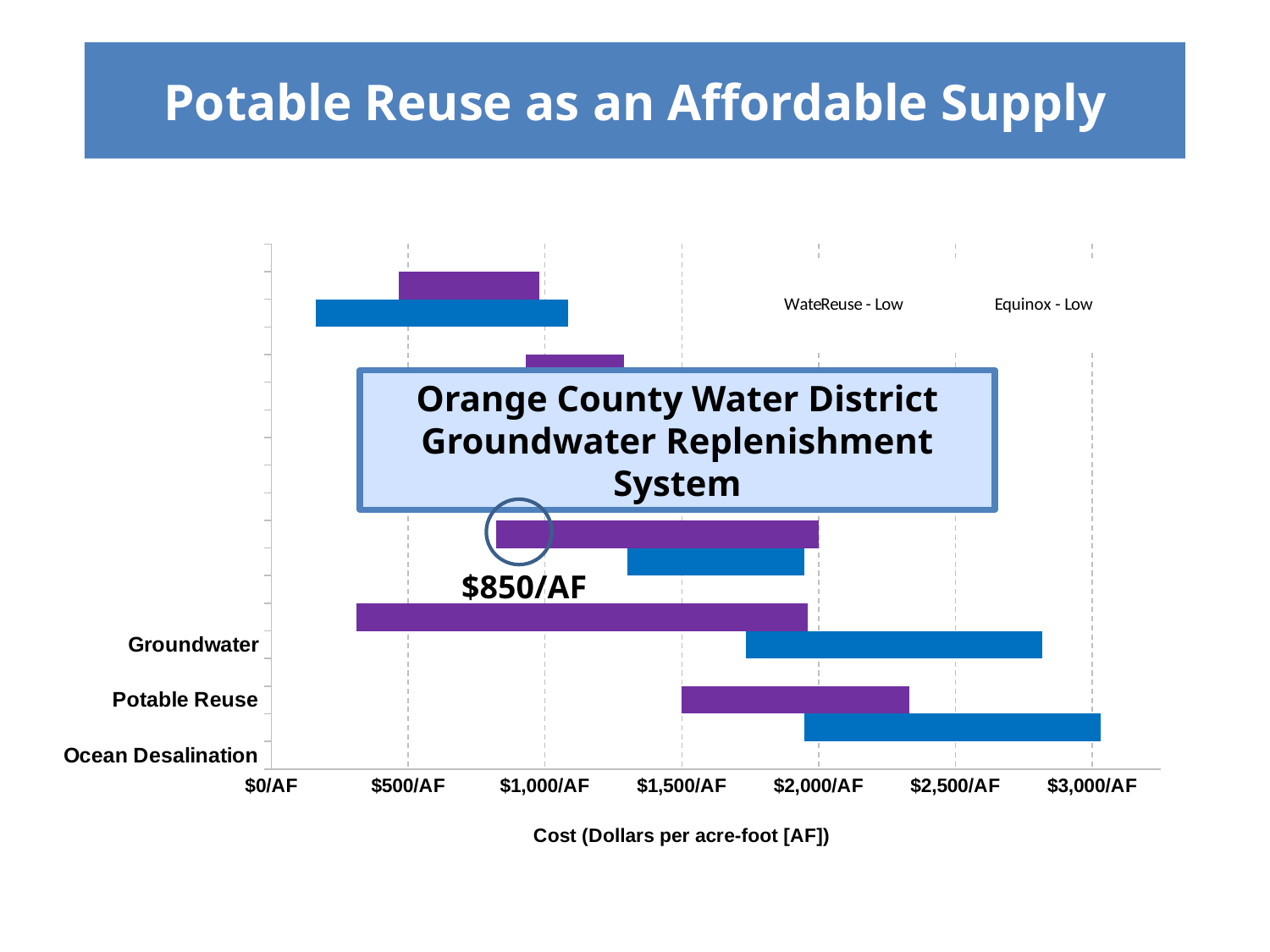
What are the two legend entries shown on the chart? WateReuse - Low and Equinox - Low Is the annotated cost for the Orange County Water District Groundwater Replenishment System greater or less than $1,000/AF? less What cost per acre-foot is annotated for the Orange County Water District Groundwater Replenishment System? $850/AF Is the annotated cost for the Orange County Water District Groundwater Replenishment System greater or less than $500/AF? greater What is the title of the x axis of the chart? Cost (Dollars per acre-foot [AF]) What is the lowest value labelled on the x axis of the chart? $0/AF What kind of chart is shown on the slide? bar chart What is the highest value labelled on the x axis of the chart? $3,000/AF